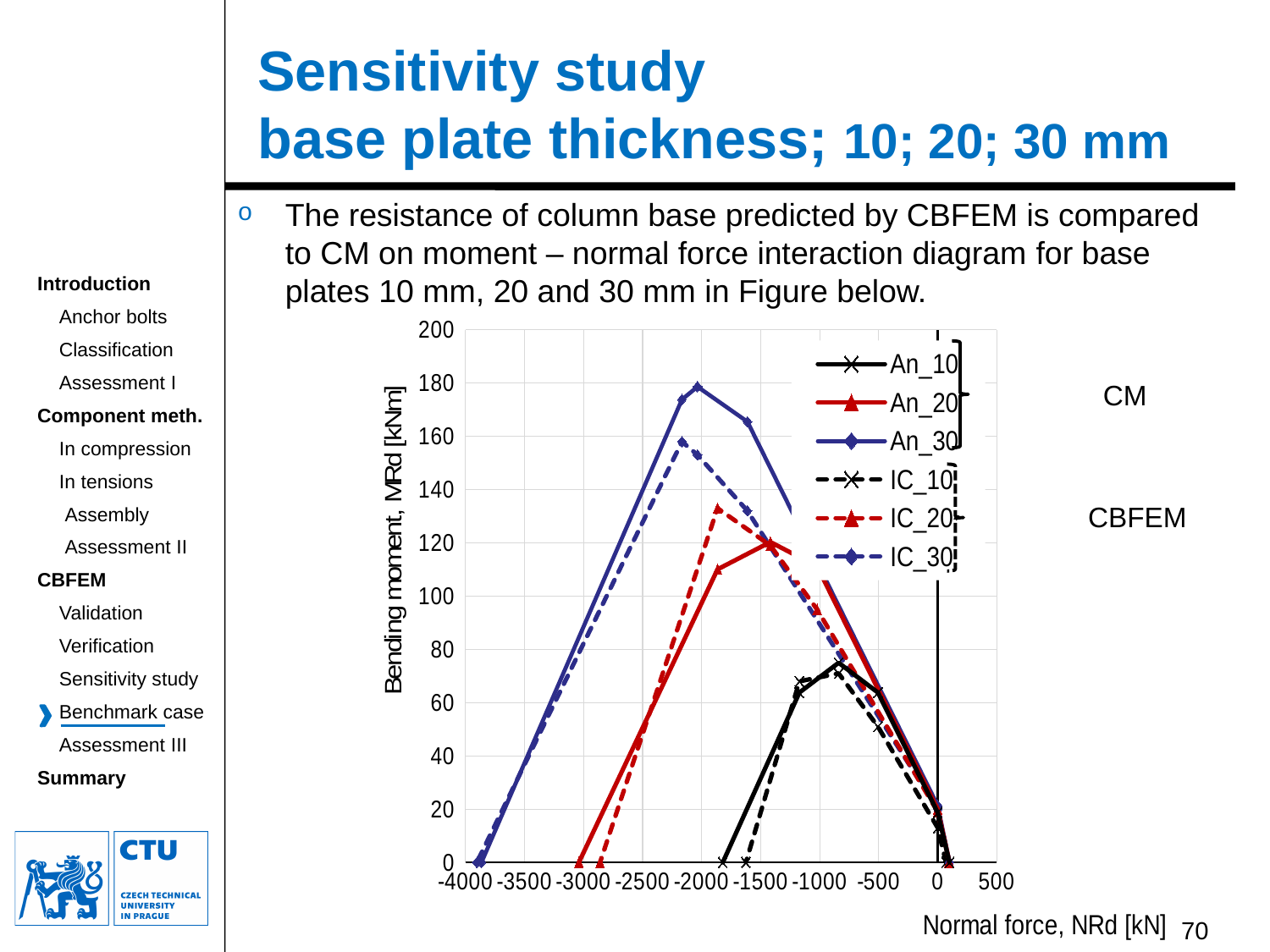
Is the peak bending moment of IC_30 greater or less than 140 kNm? greater Is the peak bending moment of An_30 greater or less than 160 kNm? greater What kind of chart is shown on the slide? line chart How many series does the chart legend list? 6 What is the label of the vertical axis of the chart? Bending moment, MRd [kNm] Is the peak bending moment of An_10 greater or less than 80 kNm? less Which series reaches the highest bending moment on the chart? An_30 Which series has the higher peak bending moment, An_30 or IC_30? An_30 Which series has the higher peak bending moment, An_20 or IC_20? IC_20 What is the label of the horizontal axis of the chart? Normal force, NRd [kN]